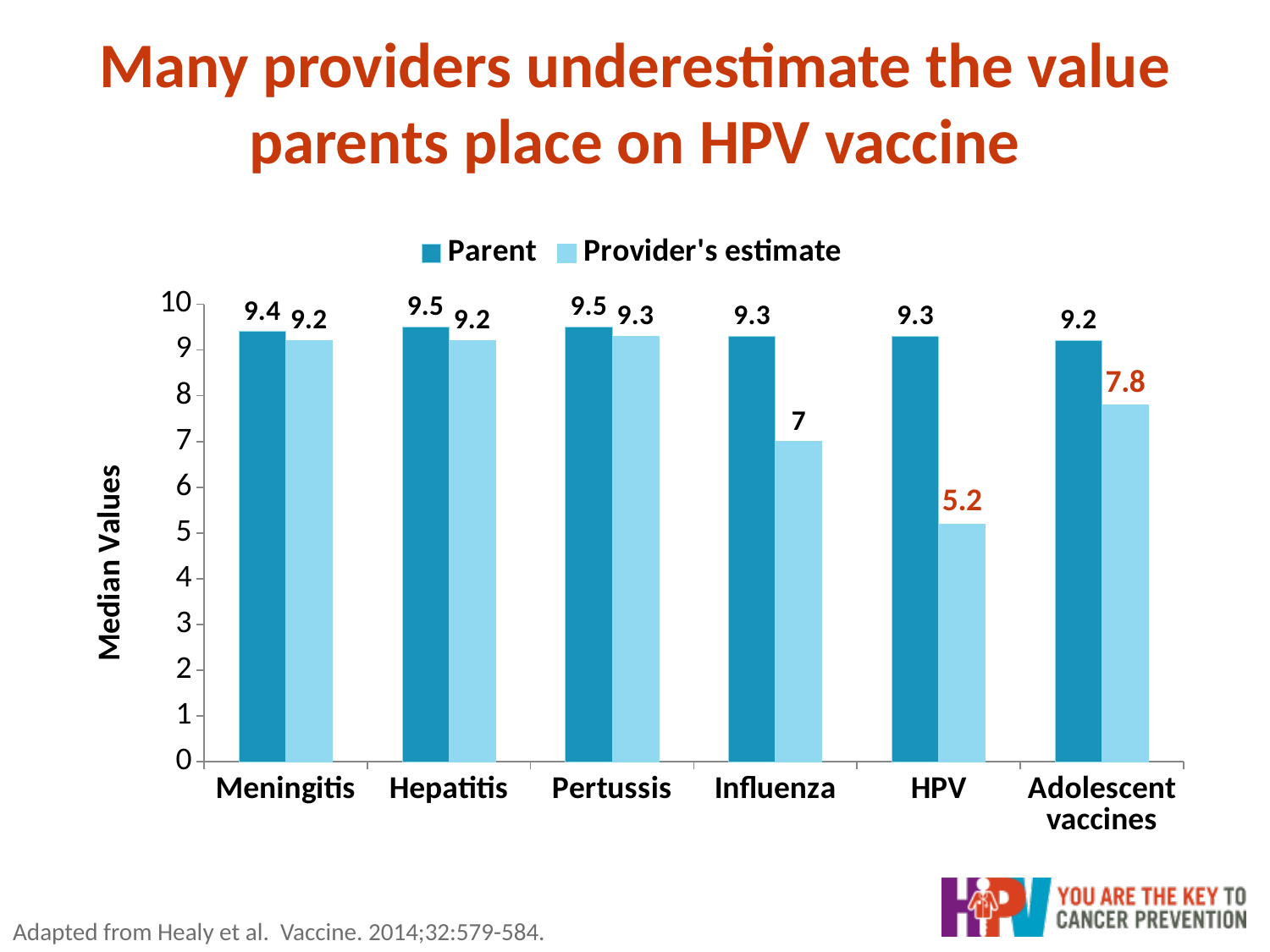
What is the difference between the Parent value and the Provider's estimate for Adolescent vaccines? 1.4 What is the Parent median value for Meningitis? 9.4 What kind of chart is shown on the slide? Bar chart What is the label of the y axis? Median Values What is the Provider's estimate for HPV? 5.2 What is the difference between the Parent value and the Provider's estimate for HPV? 4.1 How many categories are shown on the x axis? 6 Which category has the lowest Provider's estimate? HPV Which is larger for Influenza, the Parent value or the Provider's estimate? Parent What is the Provider's estimate for Influenza? 7 What is the Provider's estimate for Adolescent vaccines? 7.8 How many series does the legend list? 2